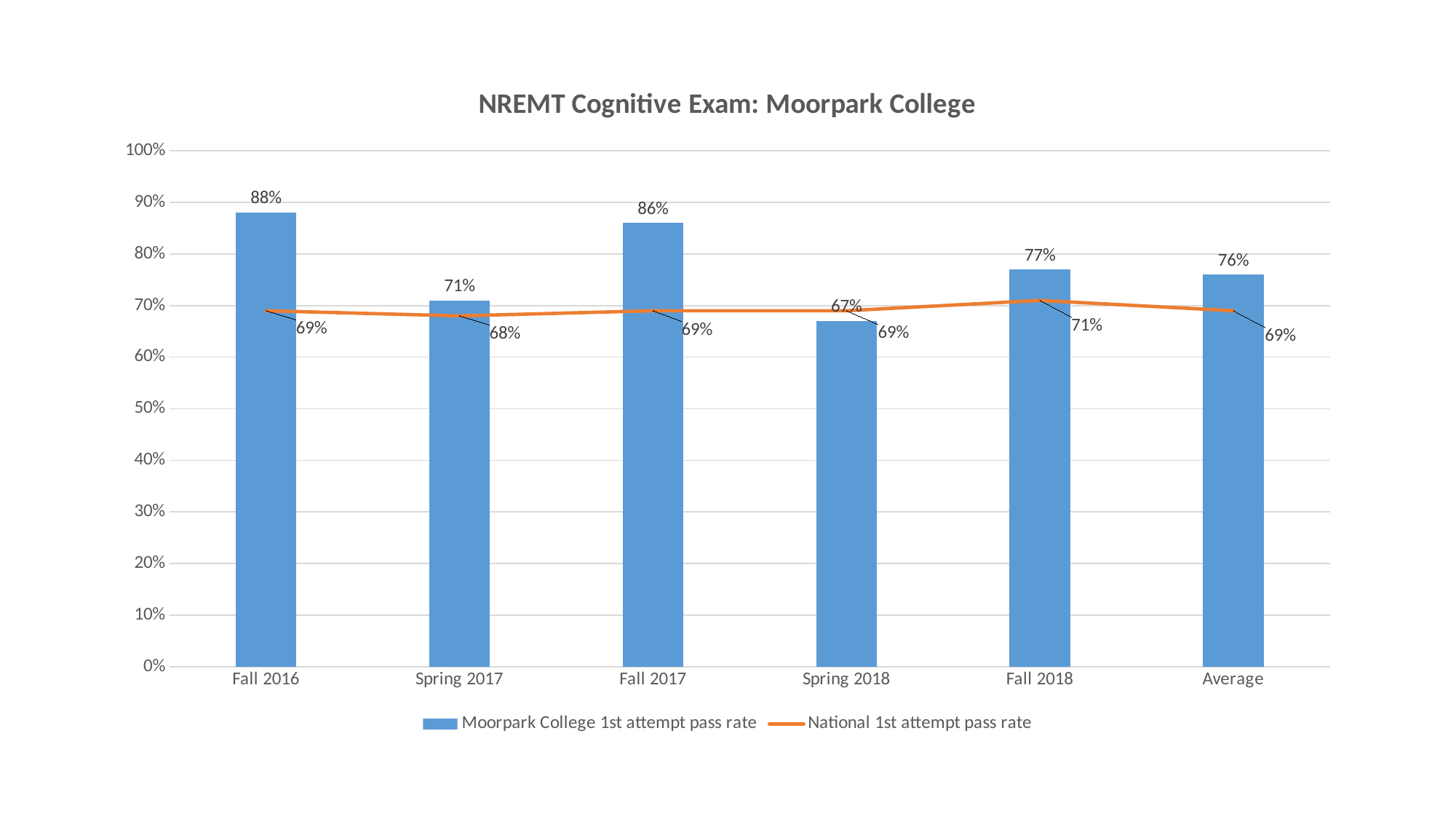
How many series does the legend list? 2 Which is larger for Spring 2018: the Moorpark College 1st attempt pass rate or the National 1st attempt pass rate? National 1st attempt pass rate What is the title of the chart? NREMT Cognitive Exam: Moorpark College What kind of chart is used for the Moorpark College 1st attempt pass rate series? Bar chart What is the Average Moorpark College 1st attempt pass rate? 76% What is the National 1st attempt pass rate for Fall 2018? 71% Which category has the lowest Moorpark College 1st attempt pass rate? Spring 2018 What is the Moorpark College 1st attempt pass rate for Spring 2018? 67% Which category has the highest Moorpark College 1st attempt pass rate? Fall 2016 How many categories are shown on the x axis? 6 What is the difference between the Moorpark College and National 1st attempt pass rates for Fall 2017? 17% What is the Moorpark College 1st attempt pass rate for Fall 2016? 88%